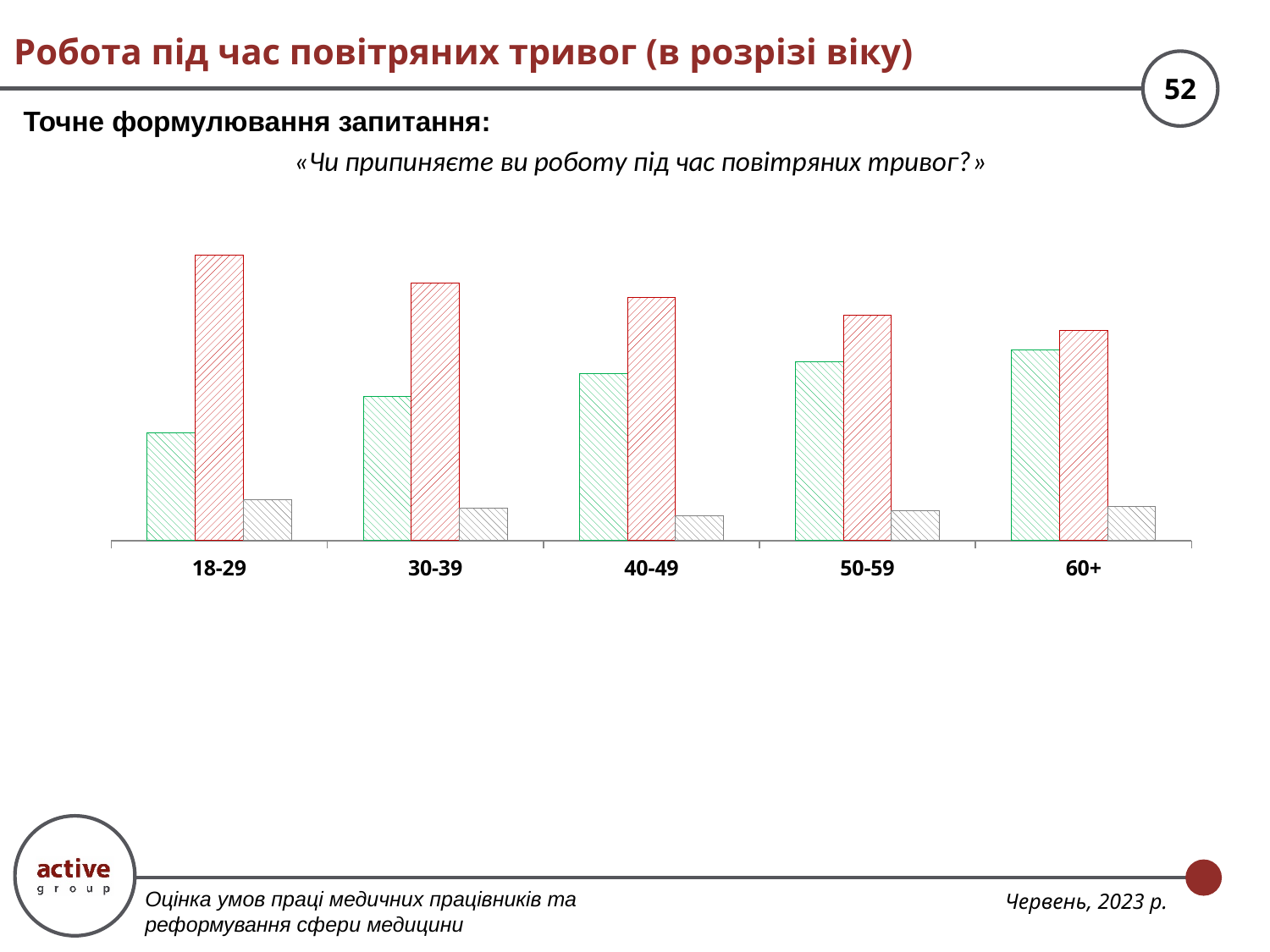
How many bars are plotted for each age group in the chart? 3 What kind of chart is shown on the slide? bar chart Which age group has the shortest red hatched bar? 60+ Do the red hatched bars rise or fall moving from the 18-29 group to the 60+ group? fall Which age group has the tallest green hatched bar? 60+ In the 18-29 age group, which bar is taller: the green hatched bar or the red hatched bar? the red hatched bar In the 40-49 age group, which bar is shorter: the green hatched bar or the grey hatched bar? the grey hatched bar How many age groups are shown on the x axis of the chart? 5 Which age group has the tallest red hatched bar? 18-29 What is the first age group label on the x axis of the chart? 18-29 Do the green hatched bars rise or fall moving from the 18-29 group to the 60+ group? rise Which age group has the shortest green hatched bar? 18-29